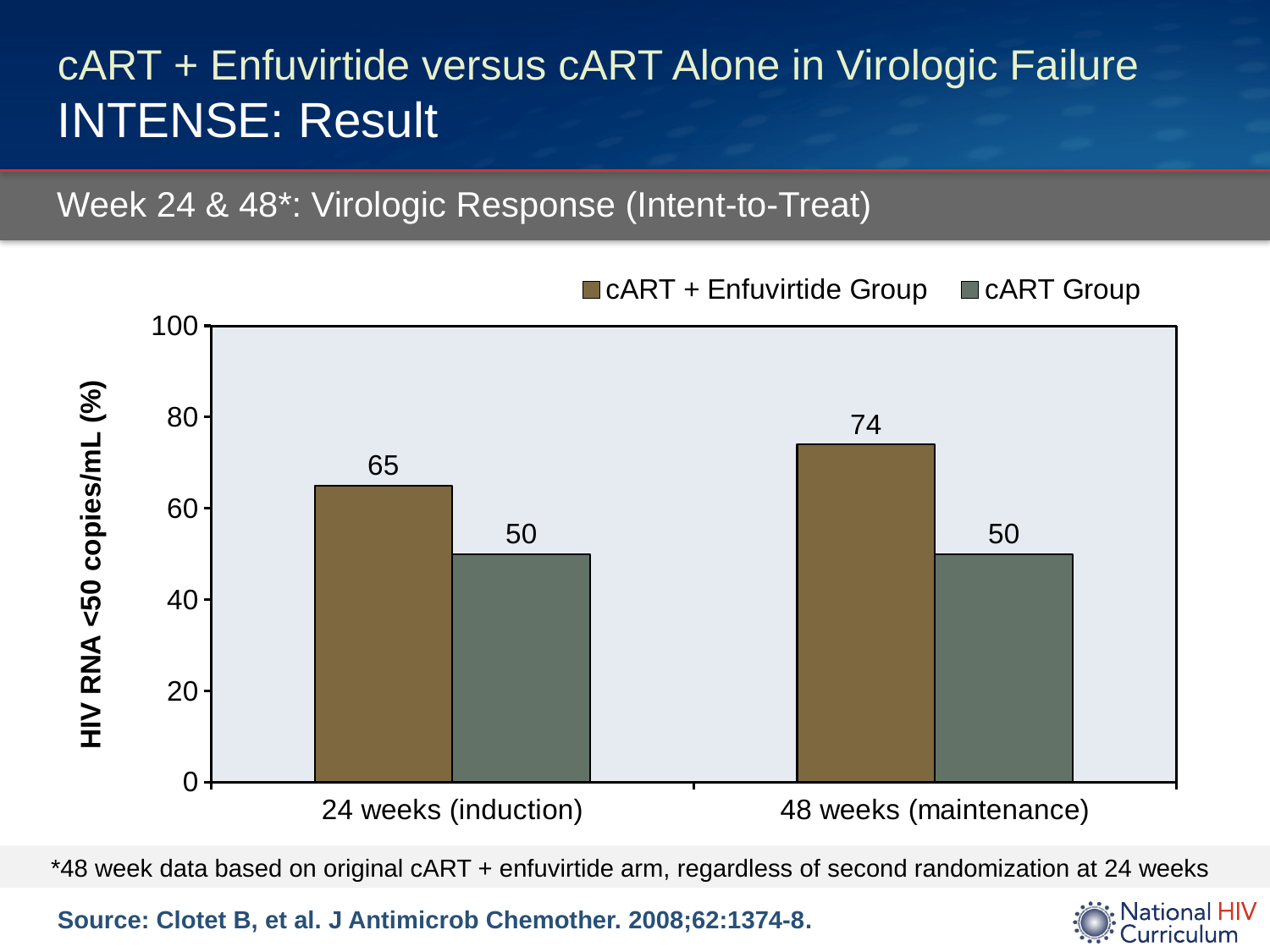
How many series does the legend list? 2 What is the value for the cART + Enfuvirtide Group at 48 weeks (maintenance)? 74 How many time-point categories are shown on the x axis? 2 What is the difference between the cART + Enfuvirtide Group and the cART Group at 48 weeks (maintenance)? 24 Which is larger at 24 weeks (induction): the cART + Enfuvirtide Group or the cART Group? cART + Enfuvirtide Group What kind of chart is shown on the slide? Bar chart What is the value for the cART Group at 48 weeks (maintenance)? 50 Which bar has the highest value on the chart? cART + Enfuvirtide Group at 48 weeks (maintenance) What is the difference between the cART + Enfuvirtide Group and the cART Group at 24 weeks (induction)? 15 Is the value for the cART + Enfuvirtide Group at 48 weeks (maintenance) greater or less than 60? greater What is the value for the cART + Enfuvirtide Group at 24 weeks (induction)? 65 What is the label of the y axis? HIV RNA <50 copies/mL (%)